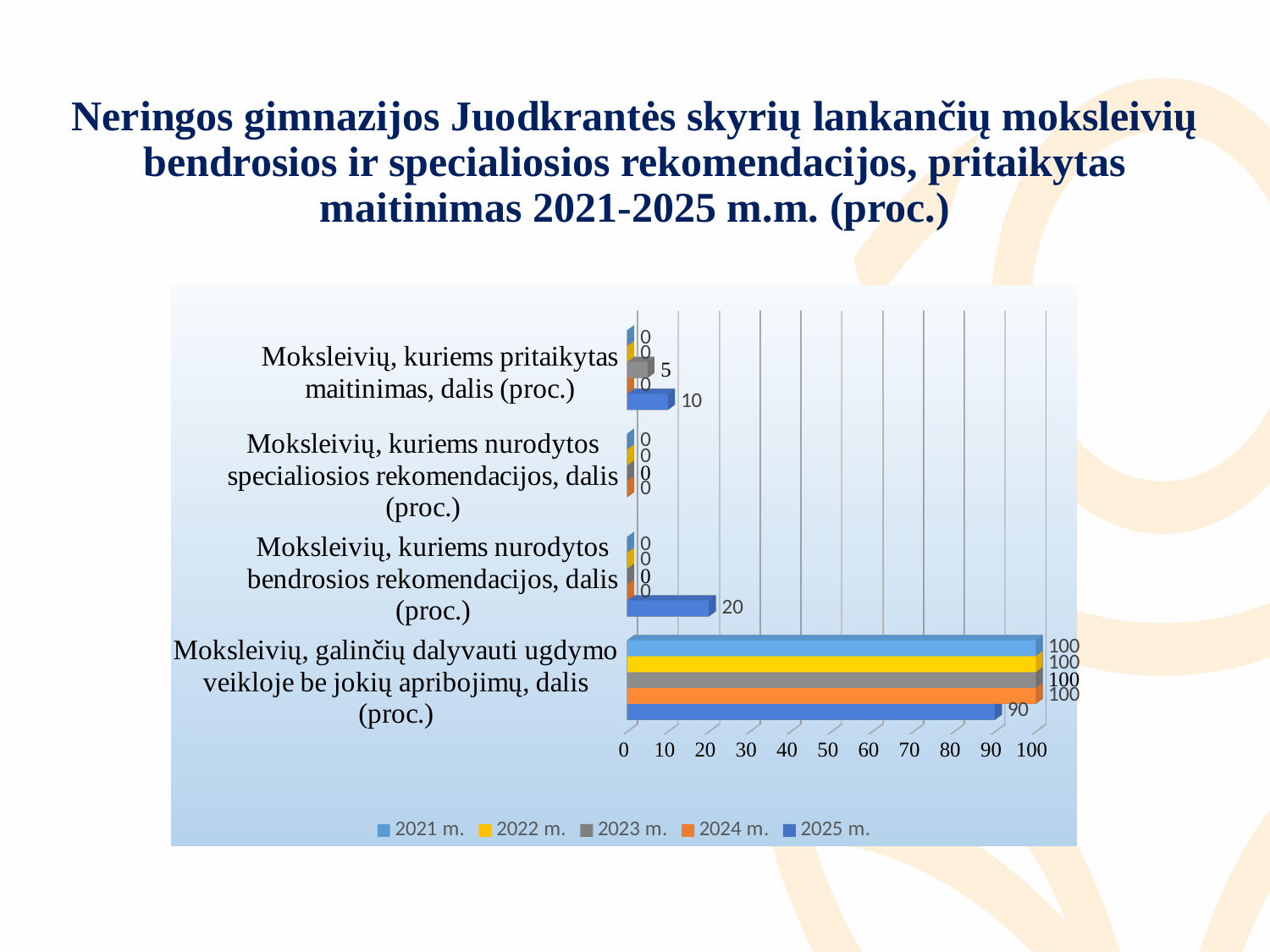
What type of chart is shown on the slide? bar chart What is the 2021 m. value for 'Moksleivių, galinčių dalyvauti ugdymo veikloje be jokių apribojimų, dalis (proc.)'? 100 How many series does the legend list? 5 What is the 2023 m. value for 'Moksleivių, kuriems pritaikytas maitinimas, dalis (proc.)'? 5 What is the difference between the 2024 m. and 2025 m. values for 'Moksleivių, galinčių dalyvauti ugdymo veikloje be jokių apribojimų, dalis (proc.)'? 10 Which is larger for 'Moksleivių, kuriems pritaikytas maitinimas, dalis (proc.)': the 2023 m. value or the 2025 m. value? 2025 m. What is the 2025 m. value for 'Moksleivių, kuriems nurodytos bendrosios rekomendacijos, dalis (proc.)'? 20 What is the 2025 m. value for 'Moksleivių, kuriems pritaikytas maitinimas, dalis (proc.)'? 10 What is the 2025 m. value for 'Moksleivių, galinčių dalyvauti ugdymo veikloje be jokių apribojimų, dalis (proc.)'? 90 Which series has the lowest value for 'Moksleivių, galinčių dalyvauti ugdymo veikloje be jokių apribojimų, dalis (proc.)'? 2025 m. Which series has the highest value for 'Moksleivių, kuriems nurodytos bendrosios rekomendacijos, dalis (proc.)'? 2025 m. How many categories are shown on the chart? 4